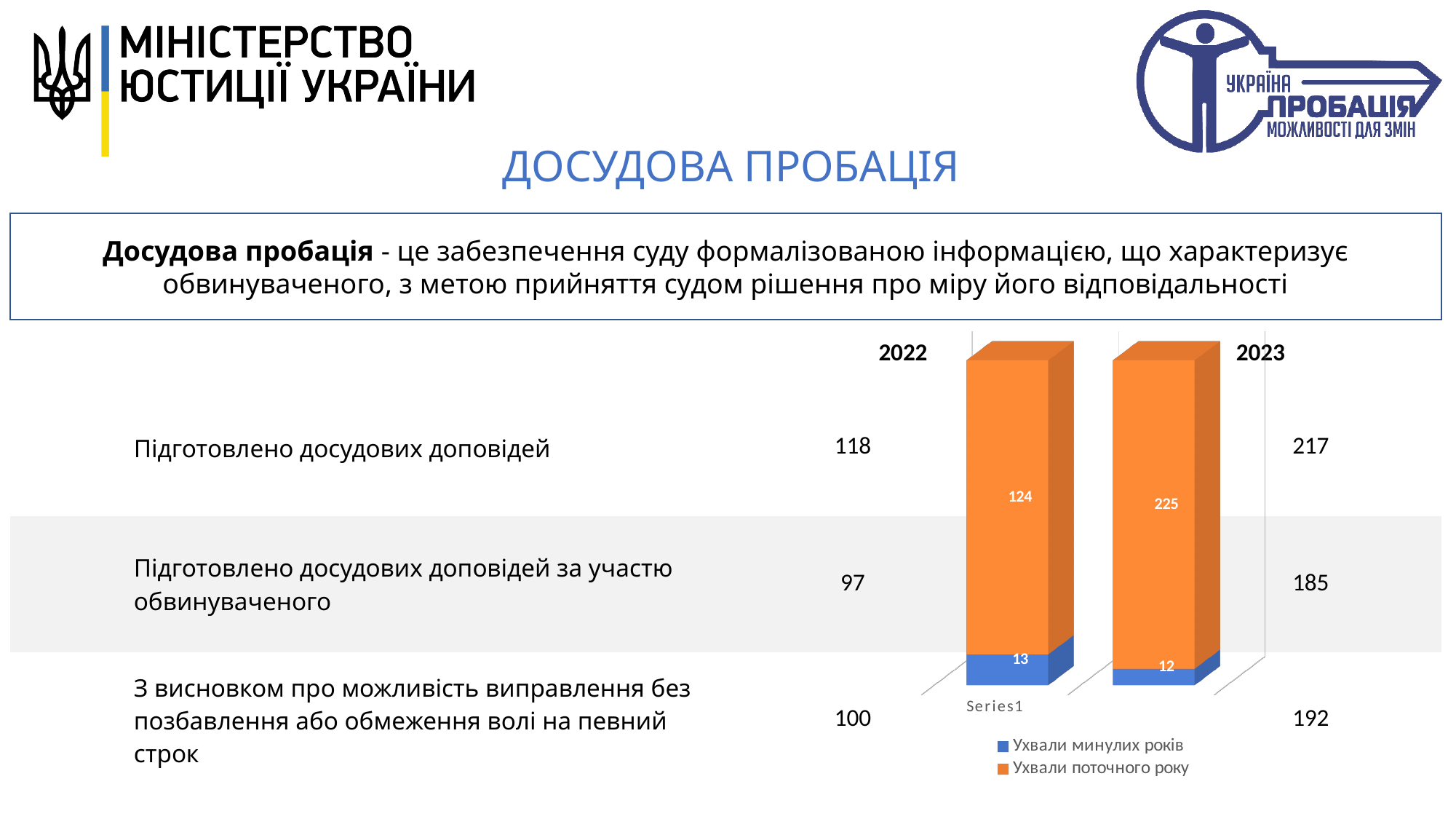
What is the value of "Ухвали поточного року" for 2023? 225 Which colour represents "Ухвали минулих років" in the chart? blue How many series does the chart legend list? 2 What is the total of the stacked bar for 2023? 237 What type of chart is shown on the slide? bar chart What is the value of "Ухвали минулих років" for 2022? 13 What is the value of "Ухвали поточного року" for 2022? 124 What is the difference between the "Ухвали поточного року" values for 2023 and 2022? 101 Which year has the higher value for "Ухвали поточного року", 2022 or 2023? 2023 What is the value of "Ухвали минулих років" for 2023? 12 What is the total of the stacked bar for 2022? 137 How many stacked bars are plotted in the chart? 2